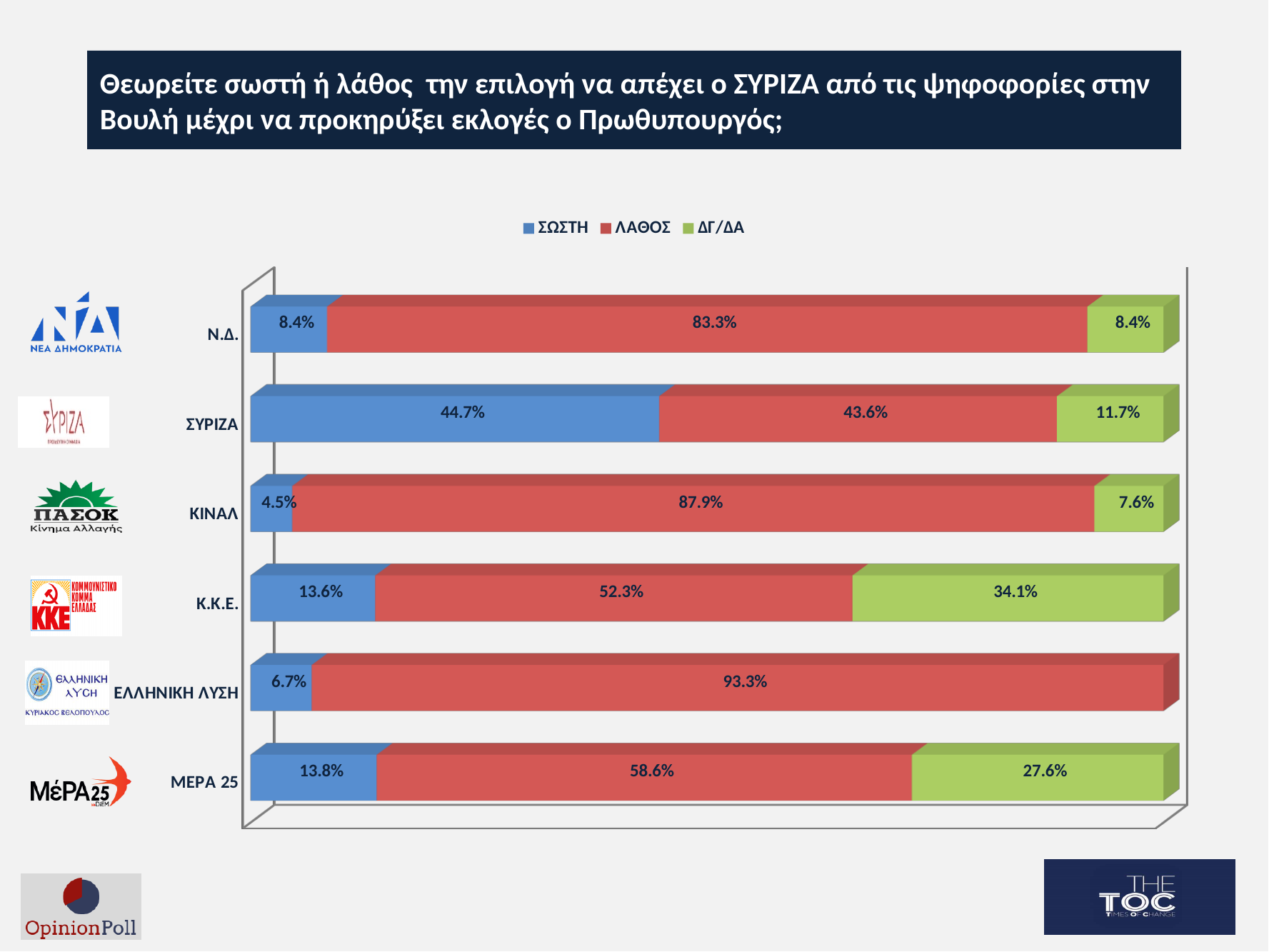
What kind of chart is shown on the slide? Stacked bar chart What percentage of ΣΥΡΙΖΑ voters answered ΣΩΣΤΗ? 44.7% How many parties are shown on the chart? 6 What is the ΛΑΘΟΣ value for ΚΙΝΑΛ? 87.9% Which party has the highest ΛΑΘΟΣ value? ΕΛΛΗΝΙΚΗ ΛΥΣΗ What is the ΛΑΘΟΣ value for ΕΛΛΗΝΙΚΗ ΛΥΣΗ? 93.3% How many series does the legend list? 3 Which colour represents the ΔΓ/ΔΑ series? Green What is the difference between the ΔΓ/ΔΑ values for Κ.Κ.Ε. and ΜΕΡΑ 25? 6.5% Which party has the lowest ΣΩΣΤΗ value? ΚΙΝΑΛ Which is larger for ΣΥΡΙΖΑ, the ΣΩΣΤΗ value or the ΛΑΘΟΣ value? ΣΩΣΤΗ What is the ΔΓ/ΔΑ value for Κ.Κ.Ε.? 34.1%